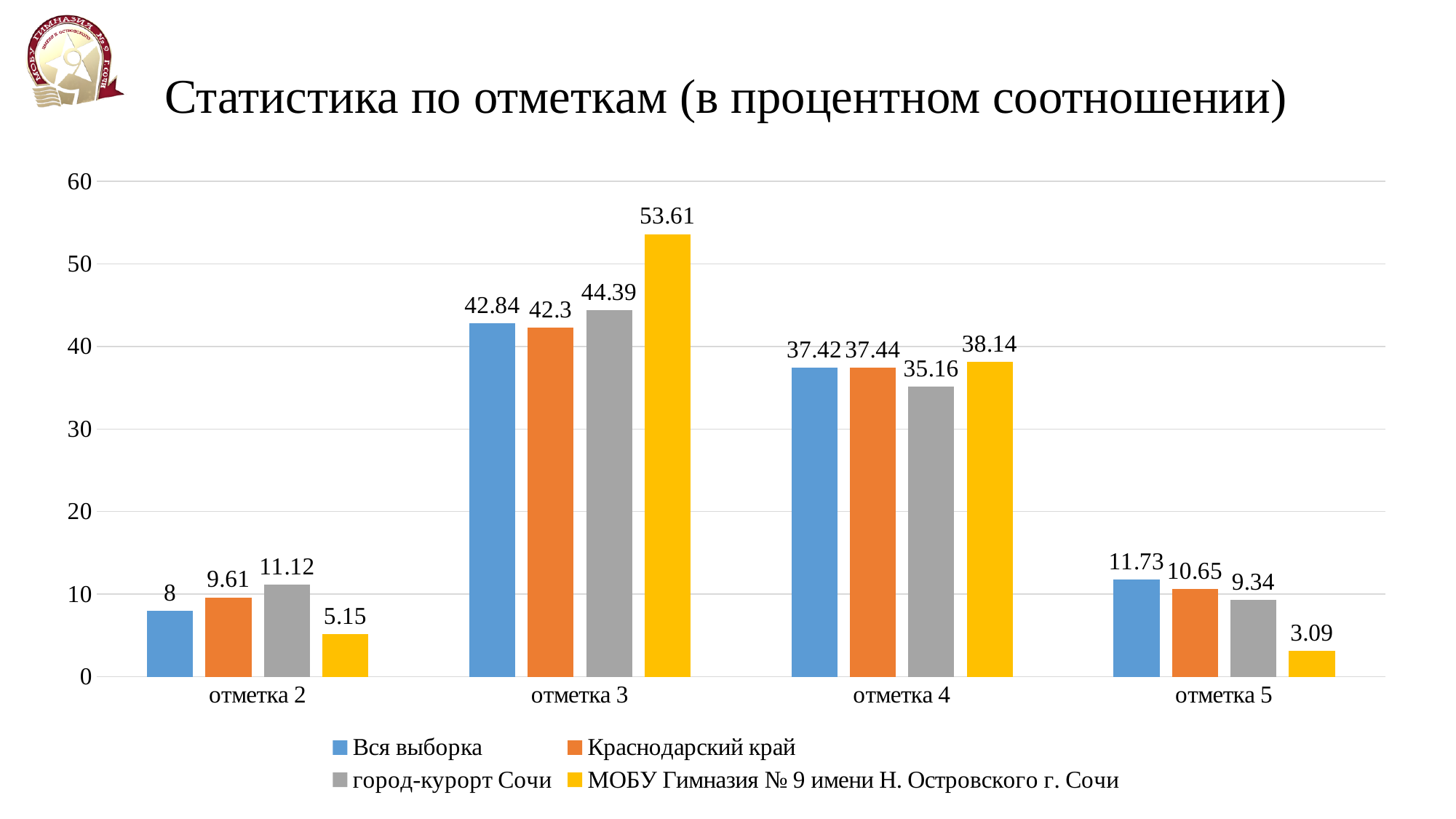
Which series has the highest value at отметка 3? МОБУ Гимназия № 9 имени Н. Островского г. Сочи What is the value for город-курорт Сочи at отметка 4? 35.16 What is the difference between the values for МОБУ Гимназия № 9 имени Н. Островского г. Сочи and Вся выборка at отметка 3? 10.77 What is the title of the slide? Статистика по отметкам (в процентном соотношении) Which is larger at отметка 2: the value for город-курорт Сочи or the value for Краснодарский край? город-курорт Сочи How many categories are shown on the x axis? 4 How many series does the legend list? 4 What is the value for Краснодарский край at отметка 5? 10.65 Which series has the lowest value at отметка 5? МОБУ Гимназия № 9 имени Н. Островского г. Сочи What kind of chart is shown on the slide? Bar chart What is the value for Вся выборка at отметка 2? 8 What is the value for МОБУ Гимназия № 9 имени Н. Островского г. Сочи at отметка 3? 53.61